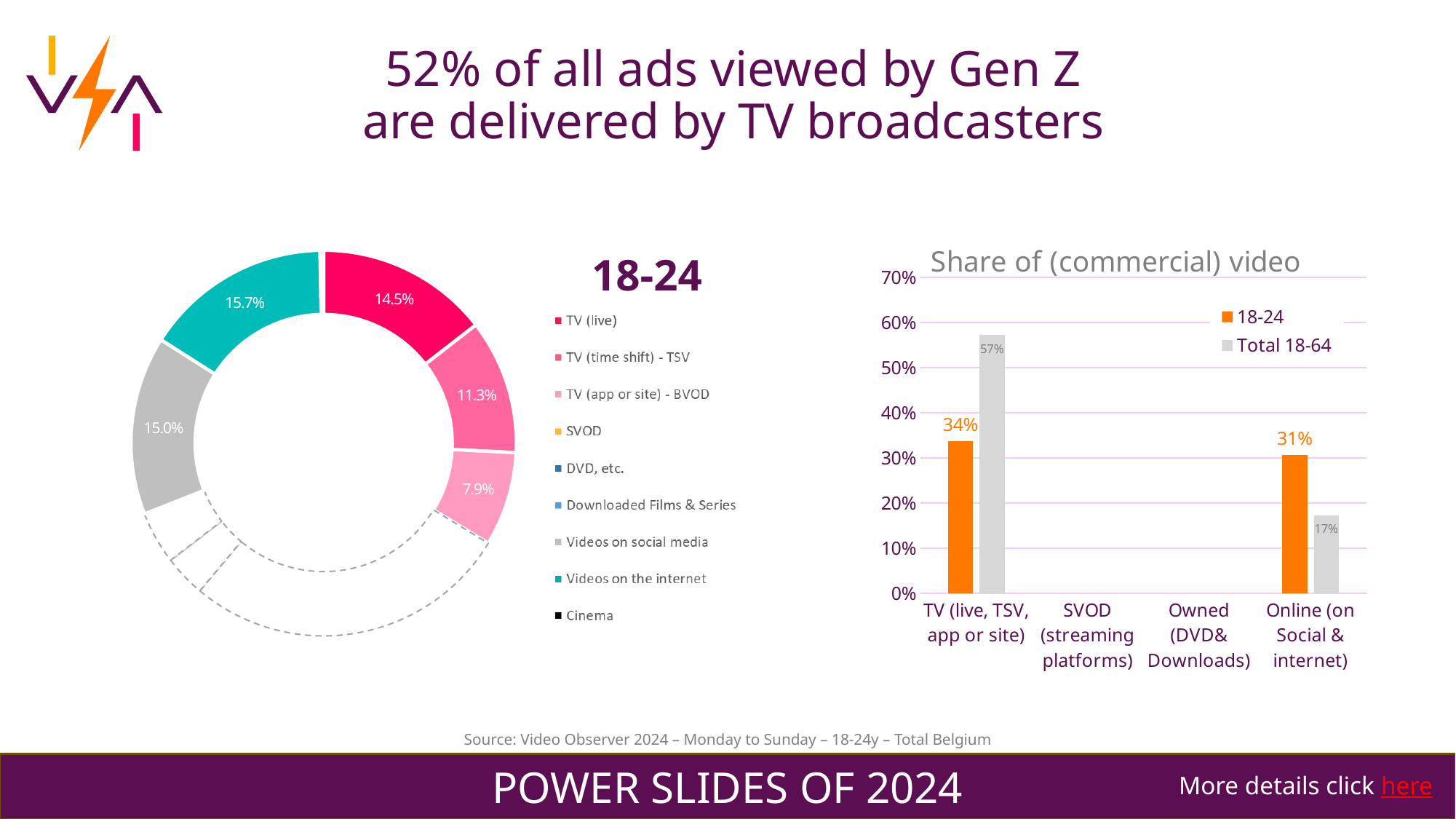
In the donut chart labelled '18-24' on the left, what is the difference between the 'TV (time shift) - TSV' value and the 'TV (app or site) - BVOD' value? 3.4% In the donut chart labelled '18-24' on the left, which is larger: 'Videos on social media' or 'TV (live)'? Videos on social media What kind of chart is the chart titled 'Share of (commercial) video'? Bar chart In the donut chart labelled '18-24' on the left, what is the value for 'Videos on the internet'? 15.7% In the donut chart labelled '18-24' on the left, how many entries does the legend list? 9 In the bar chart titled 'Share of (commercial) video', how many series does the legend list? 2 In the donut chart labelled '18-24' on the left, what is the value for 'TV (live)'? 14.5% In the bar chart titled 'Share of (commercial) video', what is the value for 18-24 in the 'TV (live, TSV, app or site)' category? 34% In the bar chart titled 'Share of (commercial) video', what is the value for Total 18-64 in the 'Online (on Social & internet)' category? 17% In the bar chart titled 'Share of (commercial) video', which is larger for 'Online (on Social & internet)': the 18-24 value or the Total 18-64 value? 18-24 In the bar chart titled 'Share of (commercial) video', how many categories are shown on the x axis? 4 In the bar chart titled 'Share of (commercial) video', what is the difference between the Total 18-64 and 18-24 values for 'TV (live, TSV, app or site)'? 23%